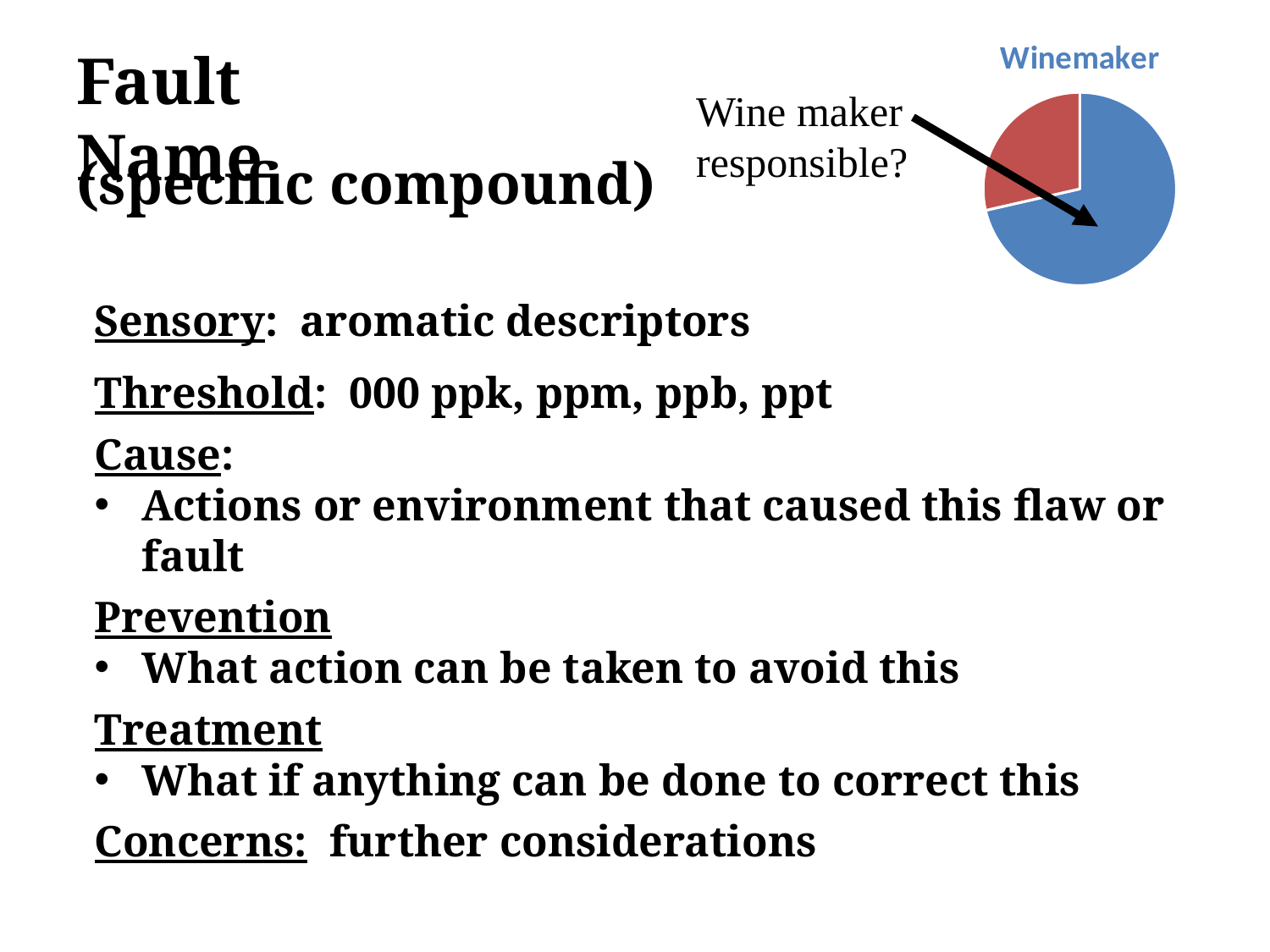
Which slice of the pie chart is larger, the blue one or the red one? the blue one What kind of chart is shown on the slide? pie chart Which colour slice is the smallest in the pie chart? red What colours are the two slices of the pie chart? blue and red How many slices does the pie chart have? 2 What is the title of the pie chart? Winemaker Which colour slice is the largest in the pie chart? blue